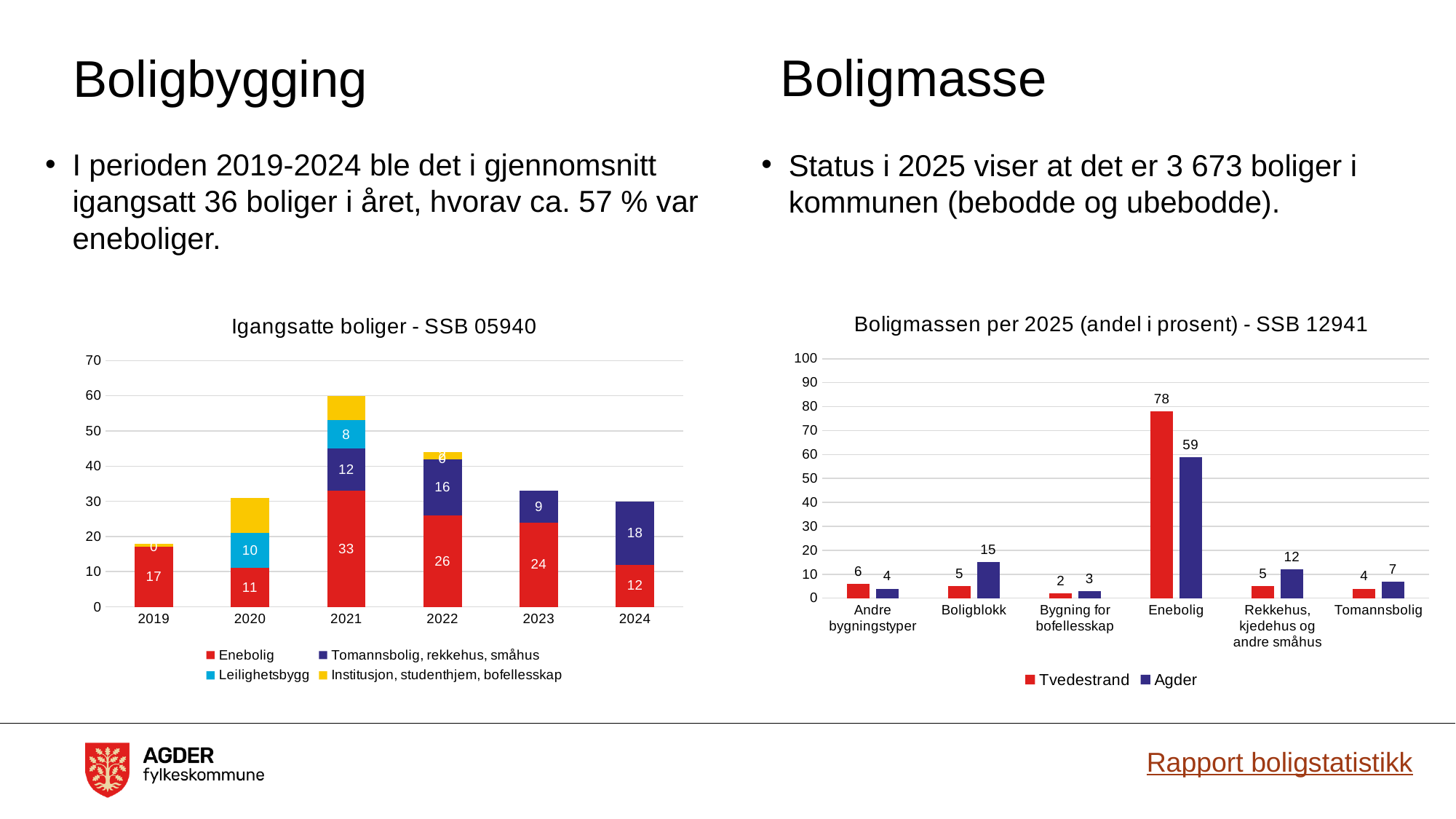
In the chart 'Igangsatte boliger - SSB 05940', how many series does the legend list? 4 In the chart 'Igangsatte boliger - SSB 05940', what is the value for Tomannsbolig, rekkehus, småhus in 2024? 18 In the chart 'Igangsatte boliger - SSB 05940', what is the total of the stacked bar for 2023? 33 In the chart 'Boligmassen per 2025 (andel i prosent) - SSB 12941', which is larger for Rekkehus, kjedehus og andre småhus: Tvedestrand or Agder? Agder In the chart 'Boligmassen per 2025 (andel i prosent) - SSB 12941', what is the Agder value for Boligblokk? 15 In the chart 'Boligmassen per 2025 (andel i prosent) - SSB 12941', what is the Tvedestrand value for Enebolig? 78 In the chart 'Igangsatte boliger - SSB 05940', what is the Leilighetsbygg value for 2020? 10 In the chart 'Igangsatte boliger - SSB 05940', which year has the highest Enebolig value? 2021 In the chart 'Boligmassen per 2025 (andel i prosent) - SSB 12941', what is the difference between the Tvedestrand and Agder values for Enebolig? 19 In the chart 'Boligmassen per 2025 (andel i prosent) - SSB 12941', how many categories are shown on the x axis? 6 In the chart 'Igangsatte boliger - SSB 05940', is the total for 2021 greater or less than 50? greater In the chart 'Igangsatte boliger - SSB 05940', what is the Enebolig value for 2021? 33